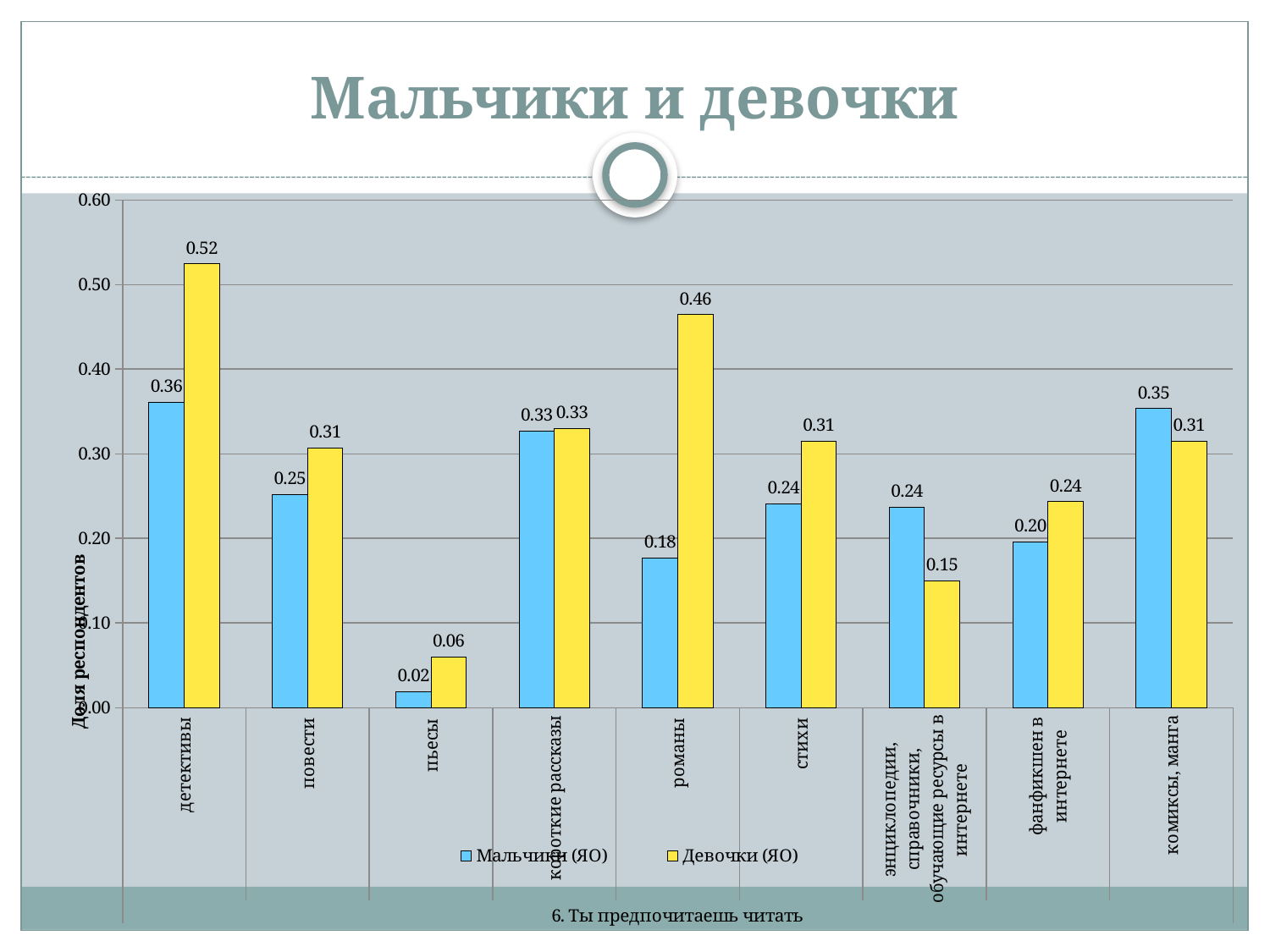
What is the title of the slide containing the chart? Мальчики и девочки What is the difference between the Девочки (ЯО) and Мальчики (ЯО) values for романы? 0.28 How many categories are shown on the x axis of the chart? 9 Is the value for Девочки (ЯО) in the детективы category greater or less than 0.50? greater What is the value for Девочки (ЯО) in the детективы category? 0.52 Which category has the highest value for Мальчики (ЯО)? детективы What is the value for Девочки (ЯО) in the пьесы category? 0.06 What type of chart is shown on the slide? bar chart How many series does the chart legend list? 2 In the комиксы, манга category, which series has the larger value: Мальчики (ЯО) or Девочки (ЯО)? Мальчики (ЯО) What is the value for Мальчики (ЯО) in the романы category? 0.18 Which category has the lowest value for Девочки (ЯО)? пьесы